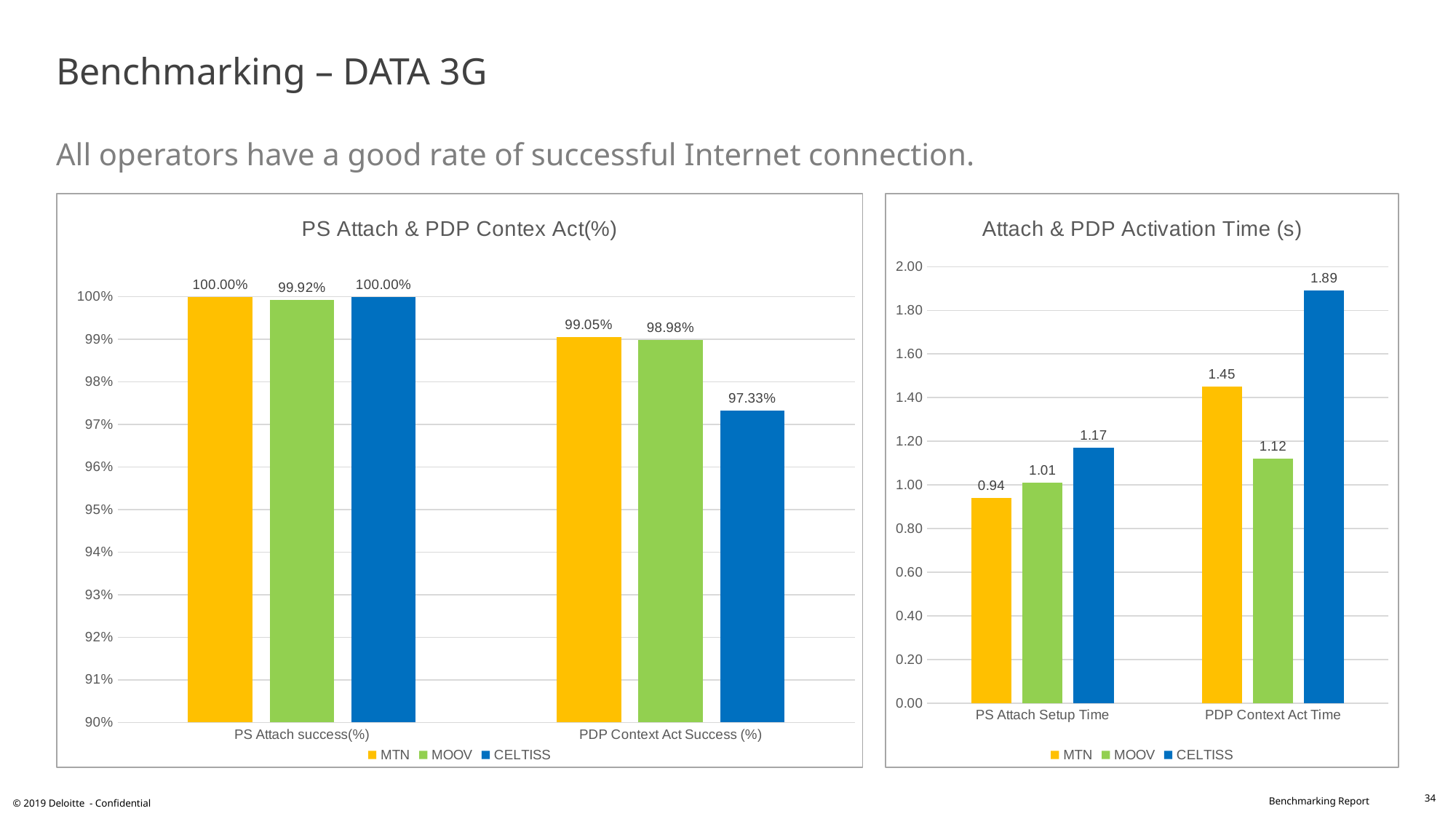
What kind of chart is the 'Attach & PDP Activation Time (s)' chart? bar chart In the 'PS Attach & PDP Contex Act(%)' chart, how many series does the legend list? 3 In the 'Attach & PDP Activation Time (s)' chart, is the PS Attach Setup Time for MOOV larger or smaller than that for CELTISS? smaller In the 'Attach & PDP Activation Time (s)' chart, what is the difference between CELTISS and MOOV in PDP Context Act Time? 0.77 In the 'PS Attach & PDP Contex Act(%)' chart, what is the value for CELTISS in PDP Context Act Success (%)? 97.33% In the 'Attach & PDP Activation Time (s)' chart, which operator has the lowest PS Attach Setup Time? MTN In the 'PS Attach & PDP Contex Act(%)' chart, which operator has the lowest PDP Context Act Success (%)? CELTISS In the 'PS Attach & PDP Contex Act(%)' chart, what is the value for MOOV in PS Attach success(%)? 99.92% In the 'PS Attach & PDP Contex Act(%)' chart, what is the difference between MTN and CELTISS in PDP Context Act Success (%)? 1.72% In the 'Attach & PDP Activation Time (s)' chart, what is the PS Attach Setup Time for MTN? 0.94 In the 'Attach & PDP Activation Time (s)' chart, which operator has the highest PDP Context Act Time? CELTISS In the 'Attach & PDP Activation Time (s)' chart, what is the PDP Context Act Time for CELTISS? 1.89